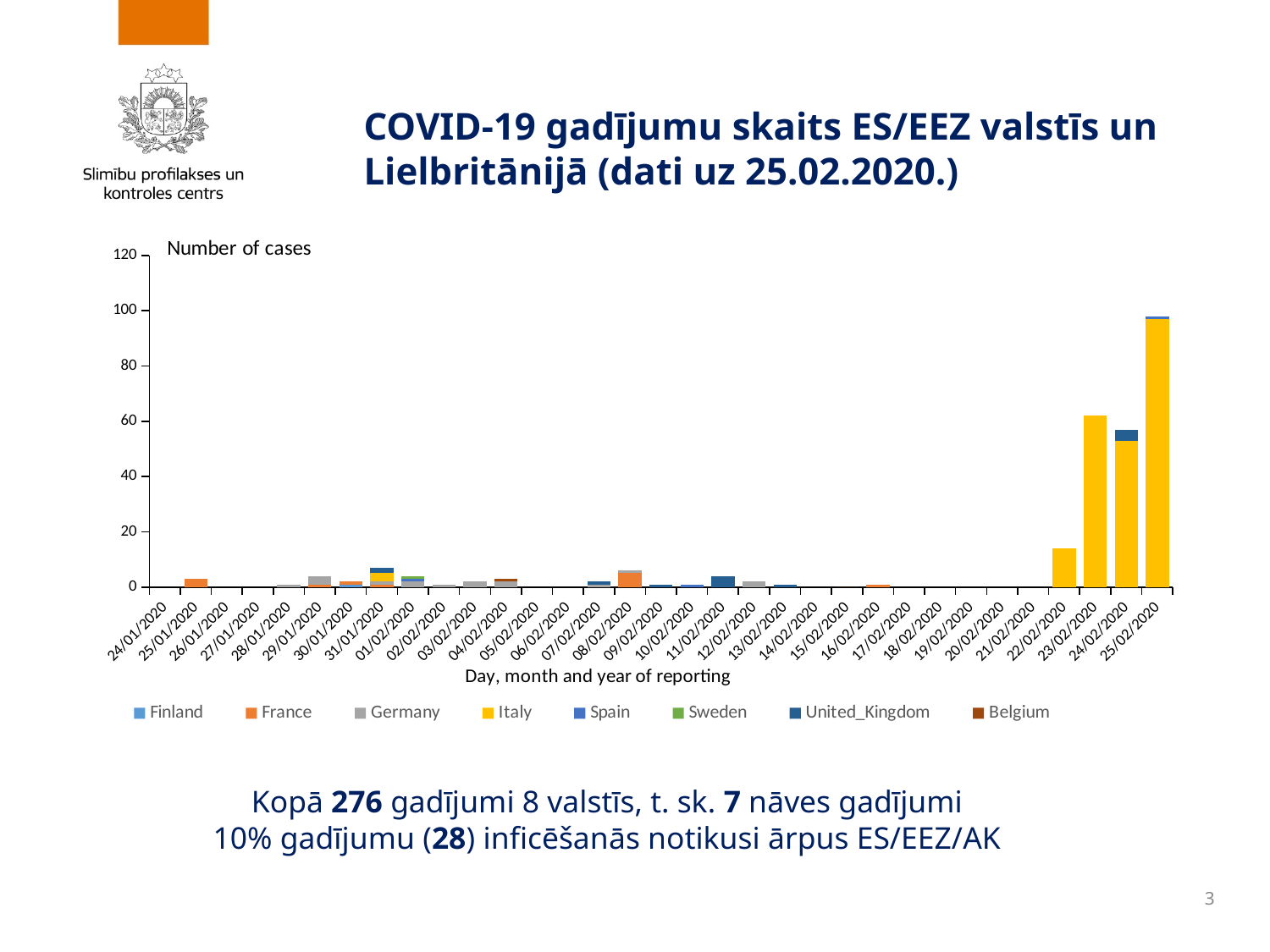
Do the number of cases rise or fall from 22/02/2020 to 25/02/2020? rise Which date has more cases, 25/02/2020 or 24/02/2020? 25/02/2020 What kind of chart is shown on the slide? bar chart Which reporting date has the highest number of cases? 25/02/2020 Is the total number of cases for 25/02/2020 greater or less than 80? greater Which date has more cases, 23/02/2020 or 22/02/2020? 23/02/2020 What is the title of the x axis? Day, month and year of reporting How many reporting dates are shown along the x axis? 33 Which country does the yellow colour represent in the legend? Italy Is the total number of cases for 22/02/2020 greater or less than 20? less Is the total number of cases for 23/02/2020 greater or less than 40? greater How many series does the legend list? 8